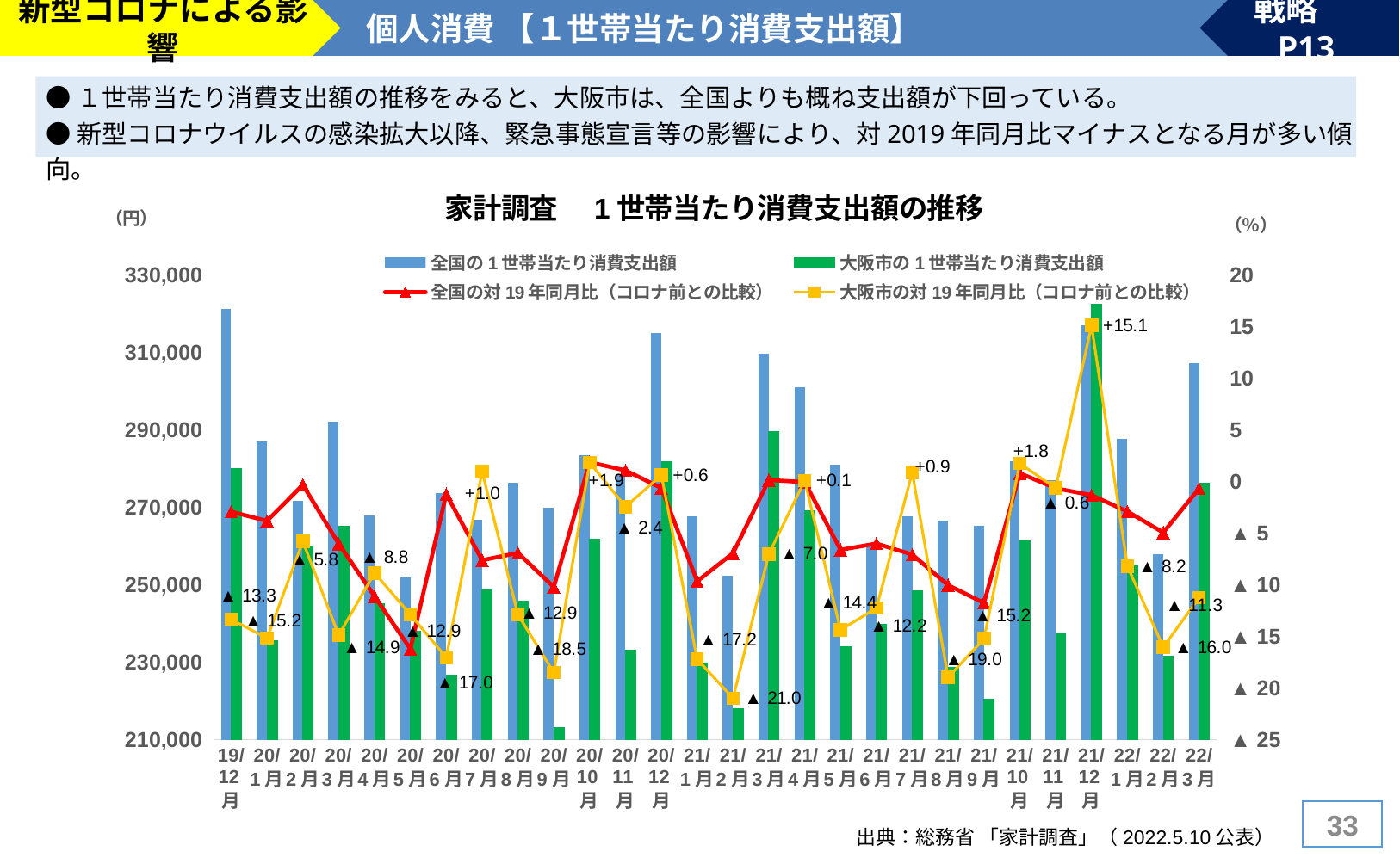
What is the value of 大阪市の対19年同月比 for 21/12月? +15.1 Which is larger for 19/12月: 全国の１世帯当たり消費支出額 or 大阪市の１世帯当たり消費支出額? 全国の１世帯当たり消費支出額 Is the value of 大阪市の１世帯当たり消費支出額 for 20/9月 greater or less than 230,000? less How many series does the chart legend list? 4 In which month is 大阪市の対19年同月比 the highest? 21/12月 What is the value of 大阪市の対19年同月比 for 21/2月? ▲21.0 How many months are shown along the x axis of the chart? 28 In which month is 大阪市の対19年同月比 the lowest? 21/2月 What kind of chart is shown on the slide? A combined bar and line chart What is the value of 大阪市の対19年同月比 for 21/10月? +1.8 By how many points does 大阪市の対19年同月比 for 21/12月 exceed that for 21/10月? 13.3 Is the value of 全国の１世帯当たり消費支出額 for 19/12月 greater or less than 310,000? greater